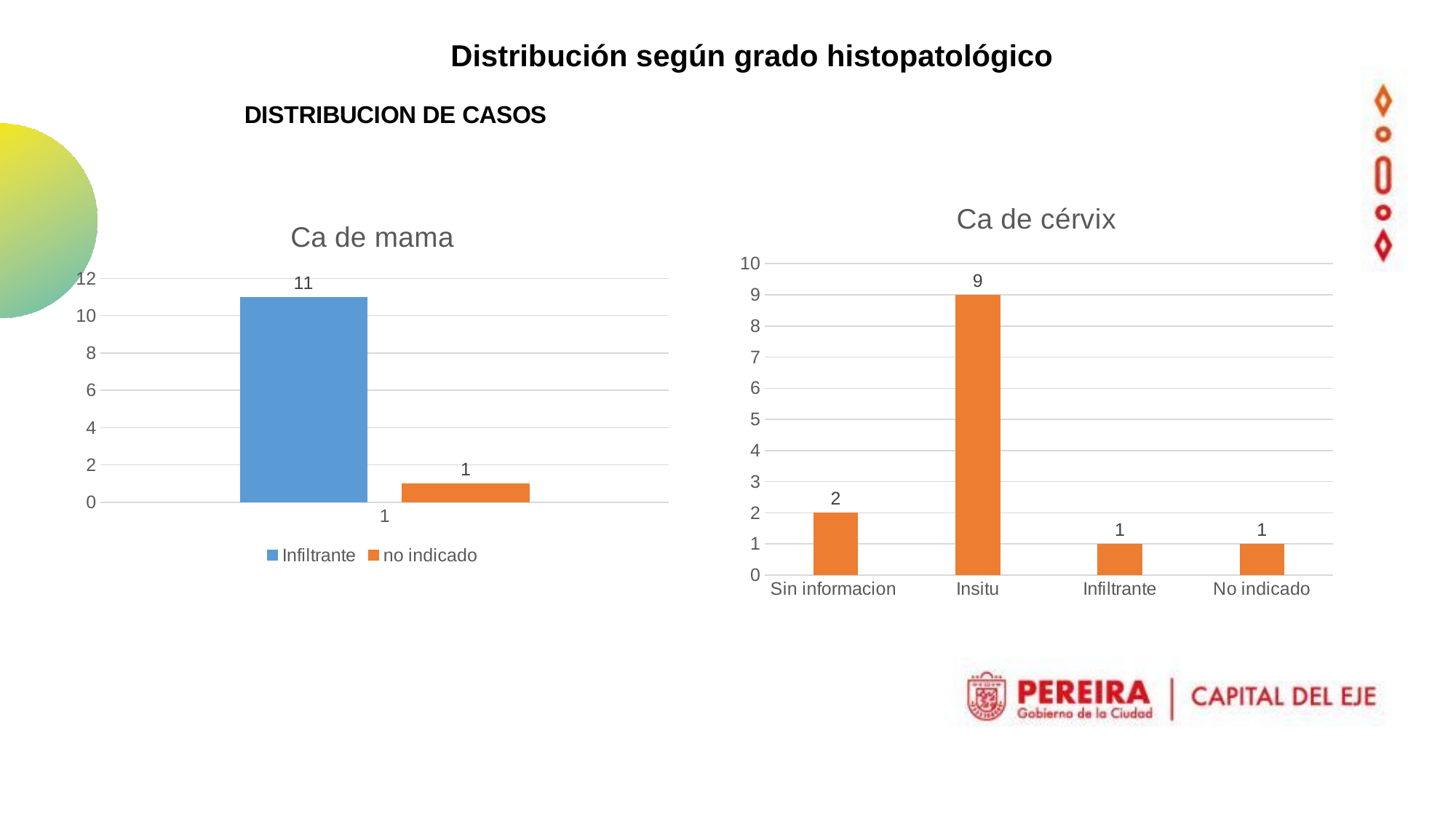
In the 'Ca de cérvix' chart, how many categories are shown on the x axis? 4 In the 'Ca de mama' chart, what is the difference between Infiltrante and no indicado? 10 In the 'Ca de cérvix' chart, what is the value for Insitu? 9 In the 'Ca de cérvix' chart, what is the value for Sin informacion? 2 In the 'Ca de mama' chart, what colour is the Infiltrante bar? Blue In the 'Ca de cérvix' chart, which is larger, Sin informacion or Infiltrante? Sin informacion What kind of chart is 'Ca de cérvix'? Bar chart In the 'Ca de mama' chart, what is the value for Infiltrante? 11 In the 'Ca de cérvix' chart, what is the difference between Insitu and Sin informacion? 7 In the 'Ca de mama' chart, what is the value for no indicado? 1 In the 'Ca de cérvix' chart, which category has the highest value? Insitu In the 'Ca de mama' chart, how many series does the legend list? 2